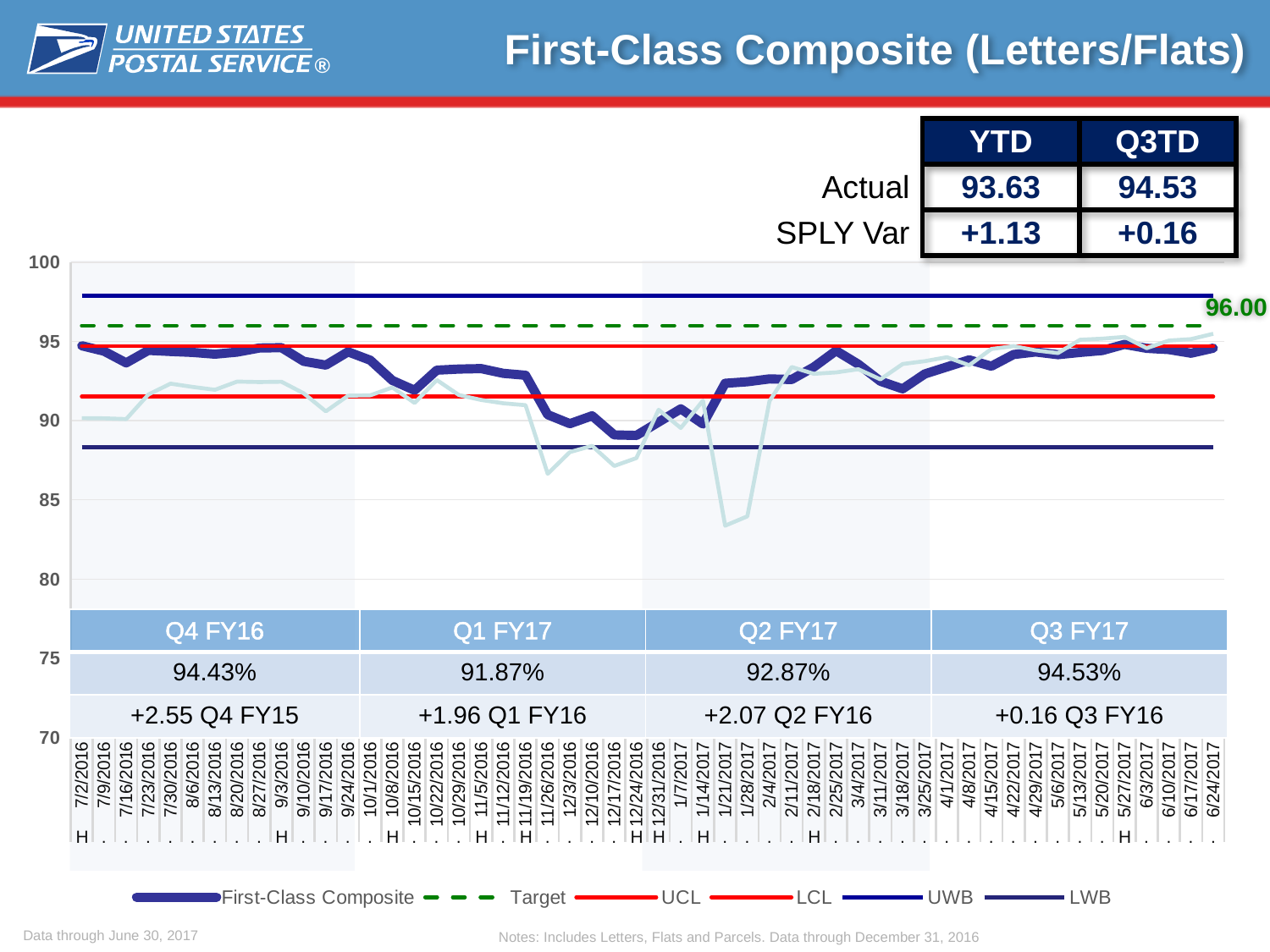
What is the difference between the Q4 FY16 value and the Q1 FY17 value shown below the chart? 2.56 What kind of chart is shown on the slide? line chart What is the value shown for Q1 FY17 in the quarter boxes below the chart? 91.87% How many series does the chart legend list? 6 Which quarter shown below the chart has the lowest value? Q1 FY17 Which quarter shown below the chart has the highest value? Q3 FY17 Does the First-Class Composite line rise or fall from 10/1/2016 to 12/17/2016? fall Which is larger, the Q2 FY17 value or the Q1 FY17 value shown below the chart? Q2 FY17 Is the First-Class Composite value for 7/2/2016 greater or less than 90? greater How many quarters are labelled in the boxes below the chart? 4 What is the value shown for Q4 FY16 in the quarter boxes below the chart? 94.43% What is the Target value labelled on the chart? 96.00